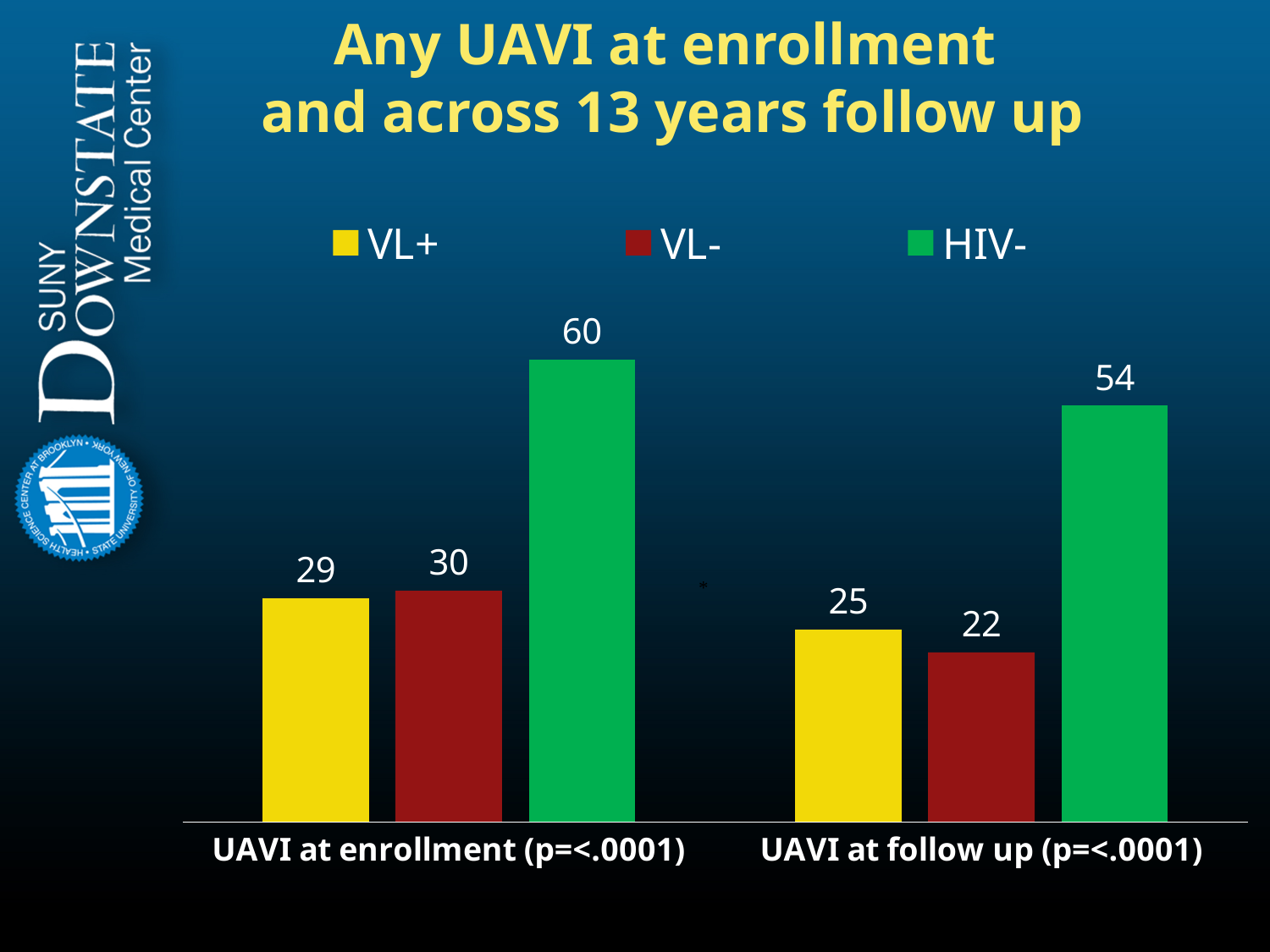
What colour represents the HIV- series? Green What kind of chart is shown on the slide? Bar chart How many series does the legend list? 3 How many categories are shown on the x axis? 2 Which series has the lowest value in the UAVI at follow up category? VL- What is the value for VL+ in the UAVI at enrollment category? 29 What is the value for VL- in the UAVI at follow up category? 22 Which series has the highest value in the UAVI at follow up category? HIV- What is the value for HIV- in the UAVI at enrollment category? 60 Which is larger: the VL+ value at enrollment or the VL+ value at follow up? VL+ at enrollment What is the difference between the HIV- values at enrollment and at follow up? 6 What is the difference between the HIV- and VL+ values in the UAVI at enrollment category? 31